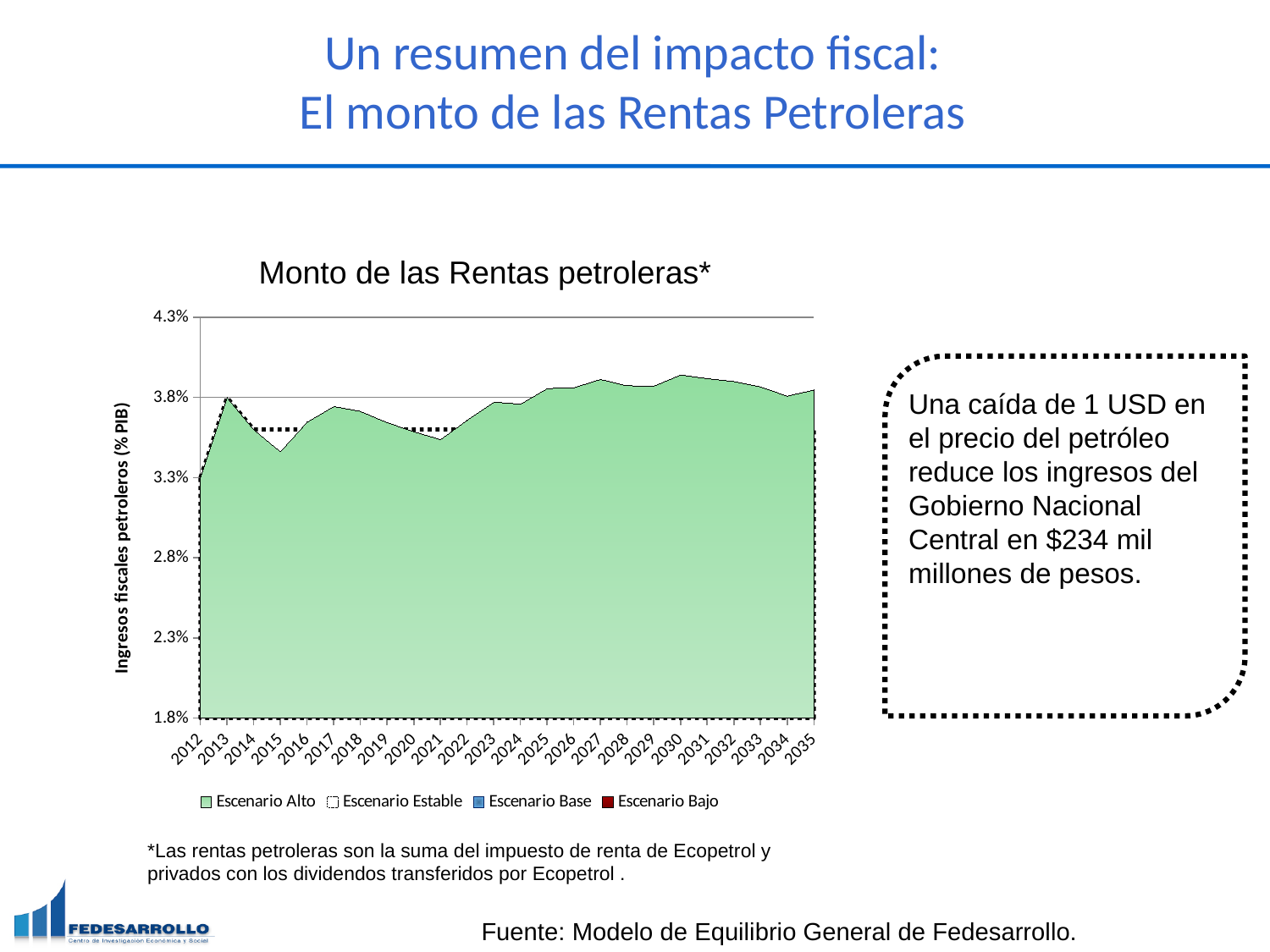
What is the label of the vertical axis? Ingresos fiscales petroleros (% PIB) How many years are shown along the x axis? 24 How many series does the chart legend list? 4 Is the value for Escenario Alto in 2030 greater or less than 3.8%? greater Is the value for Escenario Alto in 2015 greater or less than 3.3%? greater Does the Escenario Alto value rise or fall between 2013 and 2015? fall What is the title of the chart? Monto de las Rentas petroleras* Which year has the lowest value for Escenario Alto? 2012 Is the value for Escenario Alto in 2015 greater or less than 3.8%? less Which is larger for Escenario Alto, the value in 2015 or the value in 2017? 2017 What kind of chart is shown on the slide? area chart